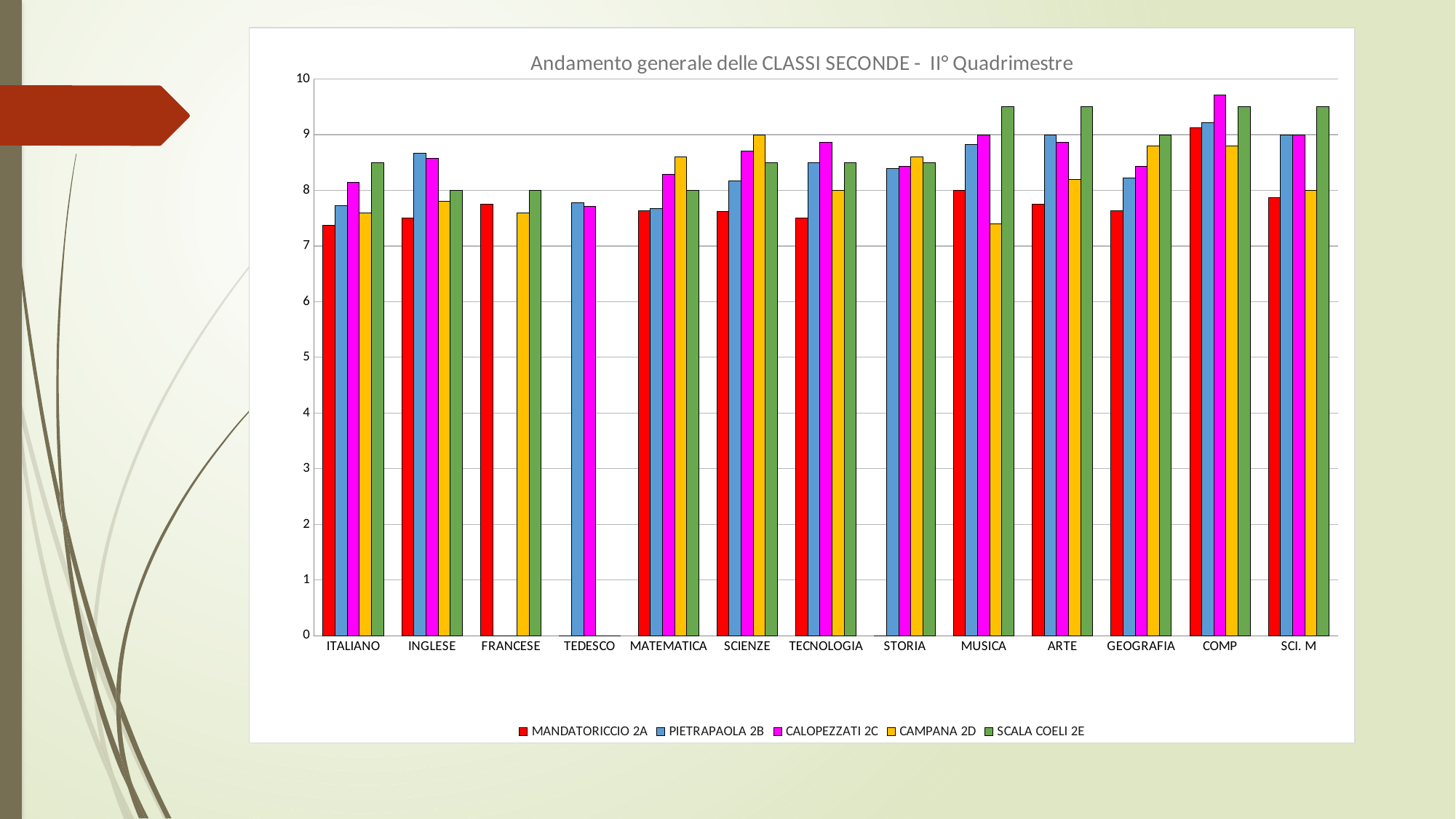
Is the value for CALOPEZZATI 2C in COMP greater or less than 9? greater How many series does the legend list? 5 What kind of chart is shown on the slide? bar chart Which series is shown in green in the legend? SCALA COELI 2E What is the title of the chart? Andamento generale delle CLASSI SECONDE - II° Quadrimestre How many subject categories are shown on the x axis? 13 Is the value for CAMPANA 2D in MUSICA greater or less than 8? less In ARTE, which is larger: the value for SCALA COELI 2E or the value for CAMPANA 2D? SCALA COELI 2E Is the value for SCALA COELI 2E in MUSICA greater or less than 9? greater Which class has the lowest value in MUSICA? CAMPANA 2D Which class has the highest value in MUSICA? SCALA COELI 2E